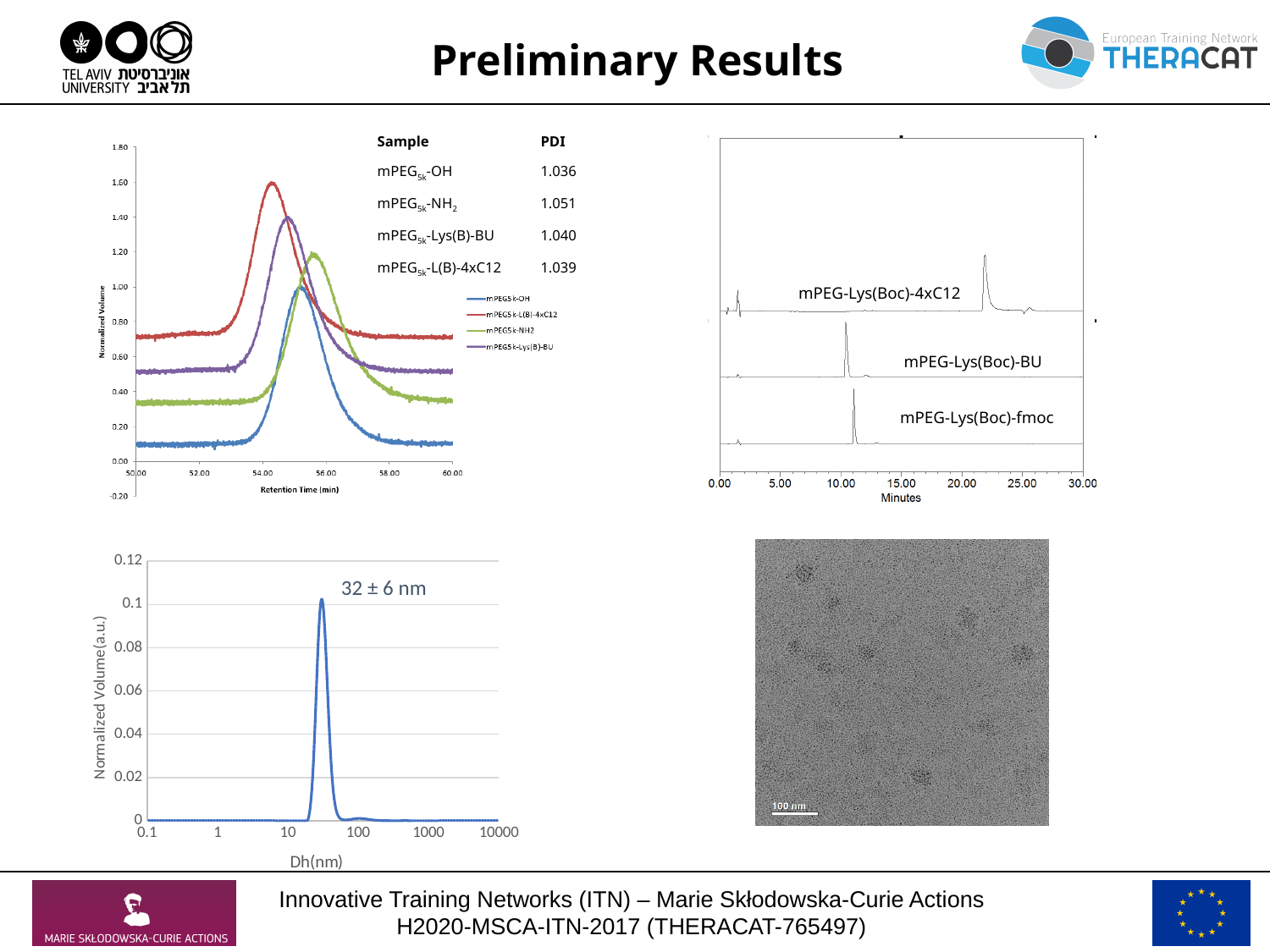
On the bottom-left chart, what particle size is printed next to the peak? 32 ± 6 nm How many series does the legend of the top-left chart (Retention Time vs Normalized Volume) list? 4 How many labelled traces are shown on the top-right chart with the x axis in Minutes? 3 On the bottom-left chart, is the height of the main peak greater or less than 0.12? less What is the x-axis label of the bottom-left chart? Dh(nm) What kind of chart is the bottom-left chart with the x axis labelled Dh(nm)? line chart In the PDI table next to the top-left chart, what is the PDI of mPEG5k-NH2? 1.051 On the top-left chart, is the peak of the mPEG5k-L(B)-4xC12 series greater or less than 1.40? greater On the top-left chart, which series has the highest peak? mPEG5k-L(B)-4xC12 On the top-right chart, is the main peak of the mPEG-Lys(Boc)-4xC12 trace at a time greater or less than 20.00 minutes? greater